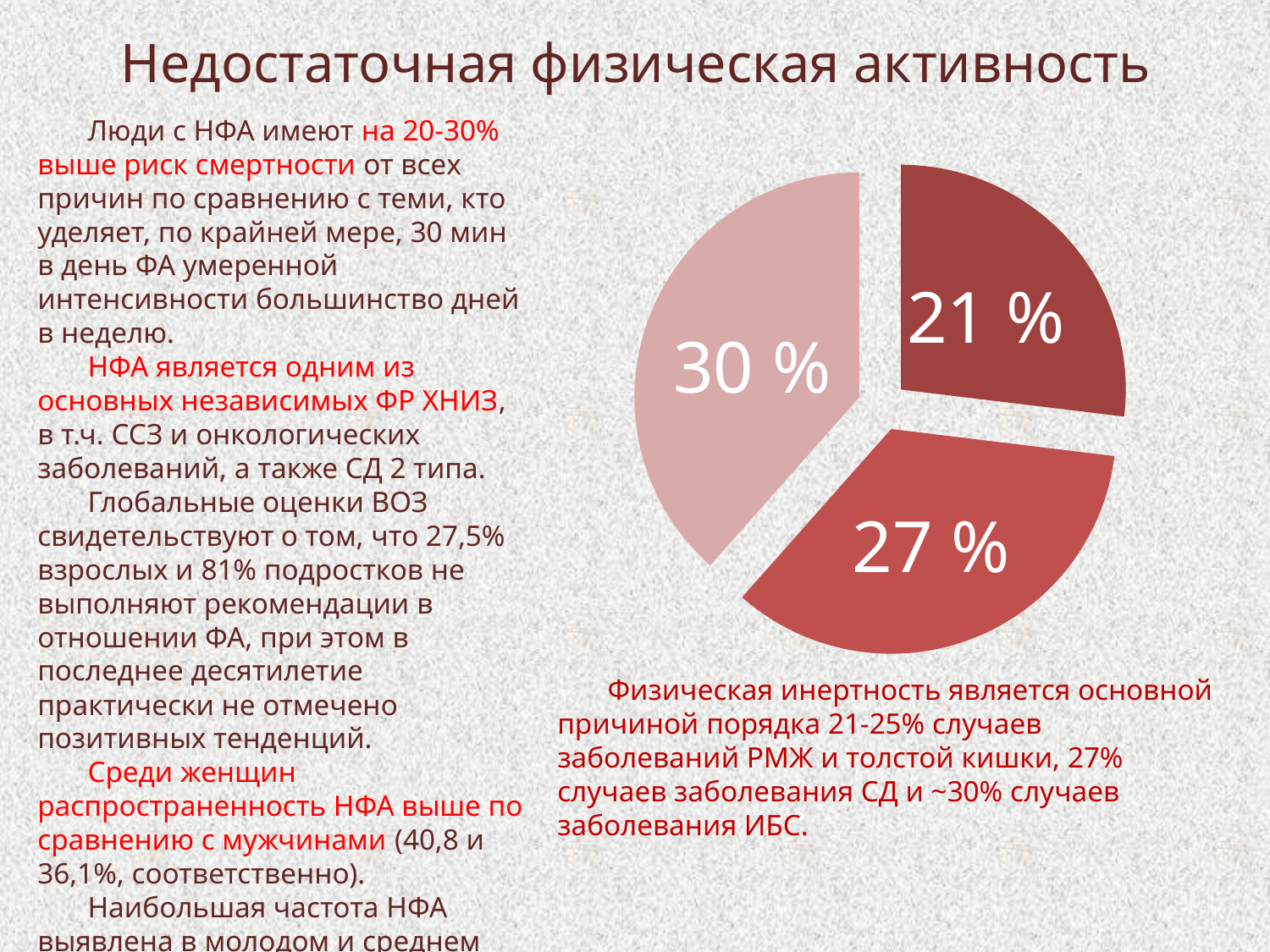
What is the title of the slide containing the pie chart? Недостаточная физическая активность What value is shown on the largest slice of the pie chart? 30 % What value is printed on the medium red slice at the bottom right of the pie chart? 27 % What value is printed on the light pink slice of the pie chart? 30 % What value is shown on the smallest slice of the pie chart? 21 % Does the pie chart have a legend? No What is the difference between the 27 % slice and the 21 % slice? 6 % What kind of chart is shown on the slide? pie chart What is the difference between the largest and smallest slice values in the pie chart? 9 % How many slices does the pie chart have? 3 What value is printed on the darkest red slice of the pie chart? 21 % Which slice is larger: the darkest red slice or the light pink slice? the light pink slice